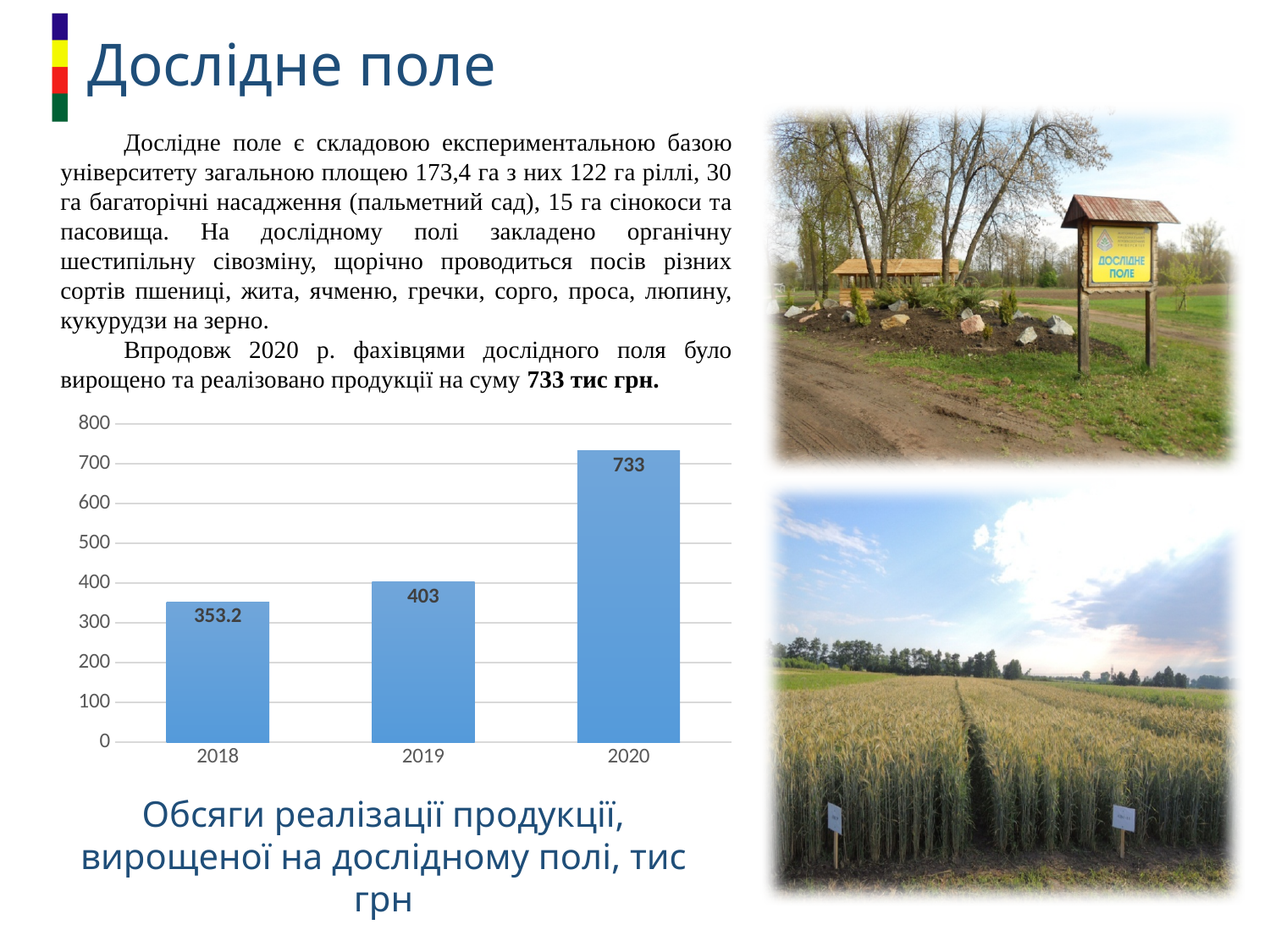
What is the difference between the values for 2020 and 2019? 330 Which is larger, the value for 2019 or the value for 2018? 2019 Do the values rise or fall from 2018 to 2020? rise What is the value for 2020 in the bar chart? 733 Is the value for 2020 greater or less than 700? greater What kind of chart is shown on the slide? bar chart Which year has the highest value in the bar chart? 2020 What is the value for 2018 in the bar chart? 353.2 Which year has the lowest value in the bar chart? 2018 What is the value for 2019 in the bar chart? 403 How many years are shown on the x axis of the bar chart? 3 What is the difference between the values for 2019 and 2018? 49.8